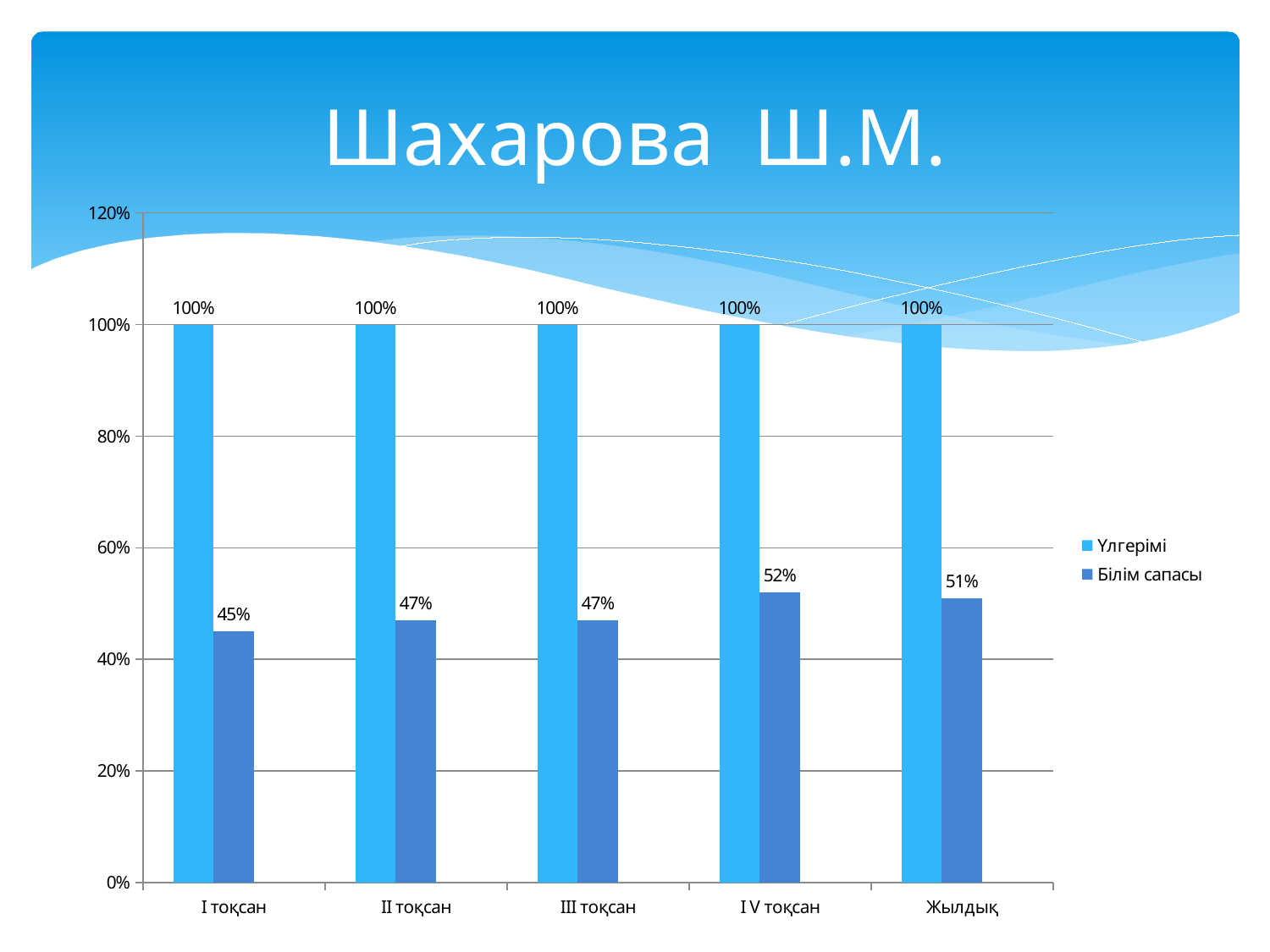
What kind of chart is shown on the slide? Bar chart Which category has the highest Білім сапасы value? IV тоқсан What is the difference between the Білім сапасы values for IV тоқсан and I тоқсан? 7% What is the title of the slide? Шахарова Ш.М. What is the value of Білім сапасы for IV тоқсан? 52% What is the value of Үлгерімі for Жылдық? 100% Which is larger, the Білім сапасы value for II тоқсан or for Жылдық? Жылдық What is the value of Білім сапасы for I тоқсан? 45% How many series does the legend list? 2 What is the value of Білім сапасы for Жылдық? 51% How many categories are shown on the x axis? 5 Which category has the lowest Білім сапасы value? I тоқсан